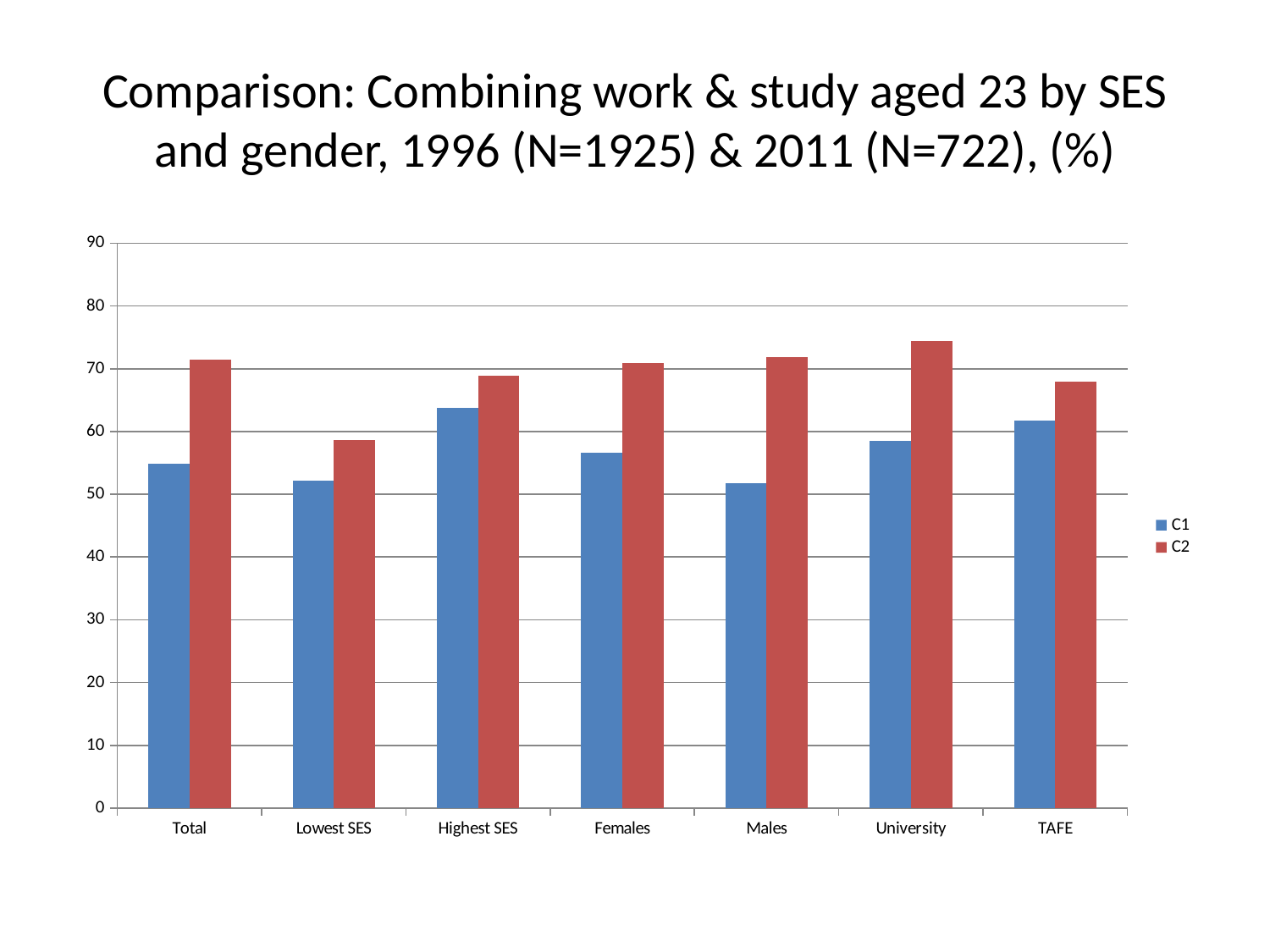
Is the C1 value for Highest SES greater or less than 60? greater Which category has the lowest C2 value? Lowest SES Is the C2 value for Lowest SES greater or less than 60? less For Males, which series has the larger value, C1 or C2? C2 Is the C2 value for Total greater or less than 70? greater Which series is shown in red? C2 What kind of chart is shown on the slide? bar chart How many categories are shown along the x axis? 7 How many series does the legend list? 2 Which category has the highest C2 value? University Which category has the highest C1 value? Highest SES